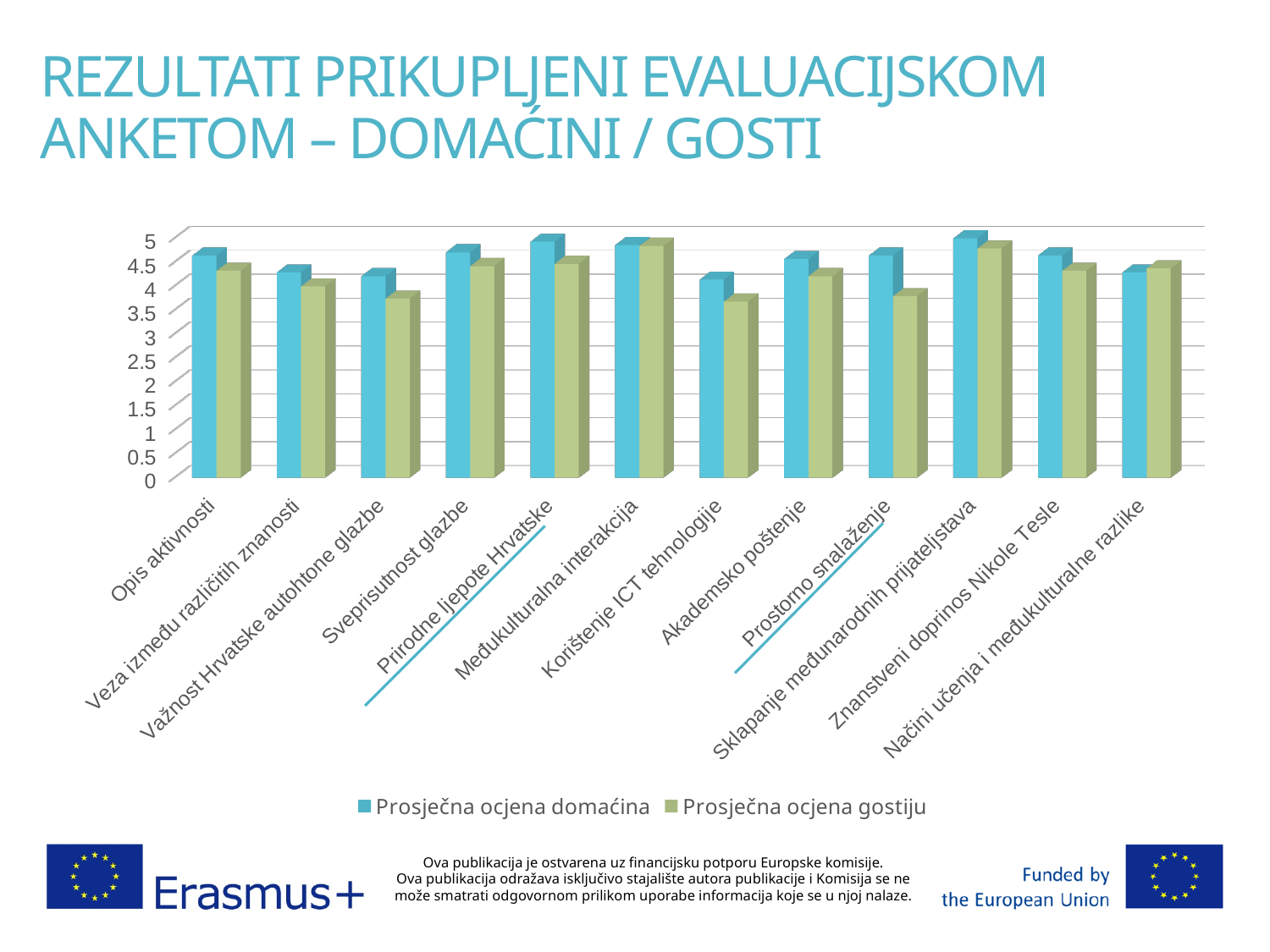
How many categories are shown on the x axis of the chart? 12 Is the value of Prosječna ocjena gostiju for Međukulturalna interakcija greater or less than 4.5? greater What are the two legend entries of the chart? Prosječna ocjena domaćina, Prosječna ocjena gostiju What kind of chart is shown on the slide? bar chart Which series is shown in blue in the chart? Prosječna ocjena domaćina Is the value of Prosječna ocjena domaćina for Korištenje ICT tehnologije greater or less than 4? greater How many series does the legend list? 2 Is the value of Prosječna ocjena domaćina for Sklapanje međunarodnih prijateljstava greater or less than 4.5? greater For Prostorno snalaženje, which is larger: Prosječna ocjena domaćina or Prosječna ocjena gostiju? Prosječna ocjena domaćina For Korištenje ICT tehnologije, which is larger: Prosječna ocjena domaćina or Prosječna ocjena gostiju? Prosječna ocjena domaćina